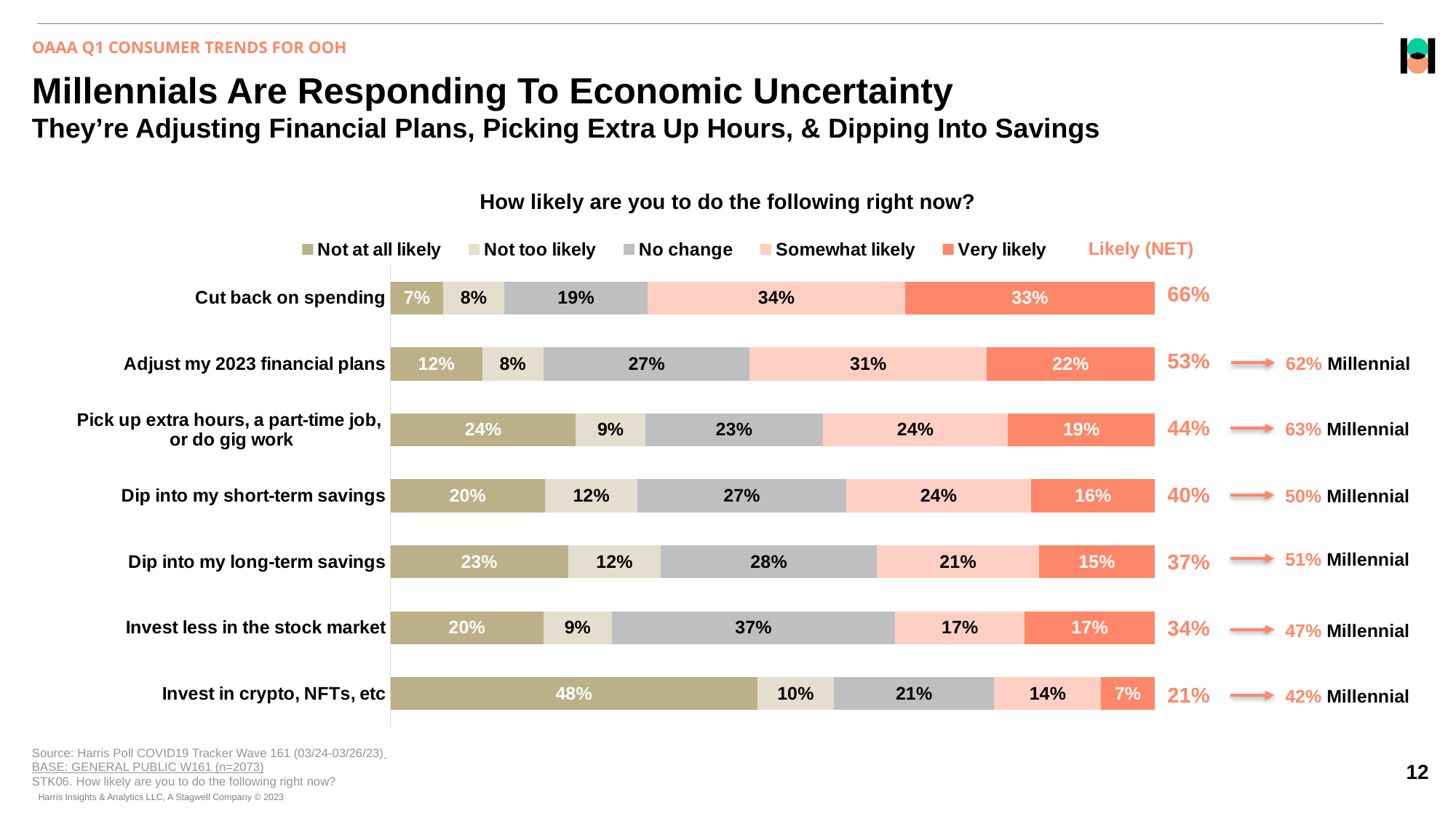
What is the Likely (NET) value for "Dip into my short-term savings"? 40% Which category has the lowest "Very likely" value? Invest in crypto, NFTs, etc What is the "No change" value for "Invest less in the stock market"? 37% What is the difference between the "Somewhat likely" values for "Cut back on spending" and "Adjust my 2023 financial plans"? 3% What is the "Not at all likely" value for "Invest in crypto, NFTs, etc"? 48% Which is larger: the "Not at all likely" value for "Dip into my long-term savings" or for "Dip into my short-term savings"? Dip into my long-term savings Which category has the highest Likely (NET) value? Cut back on spending What kind of chart is shown on the slide? Stacked bar chart What is the Millennial Likely (NET) value for "Pick up extra hours, a part-time job, or do gig work"? 63% How many series does the legend list? 5 What percentage of respondents are "Very likely" to cut back on spending? 33% How many categories are shown in the chart? 7